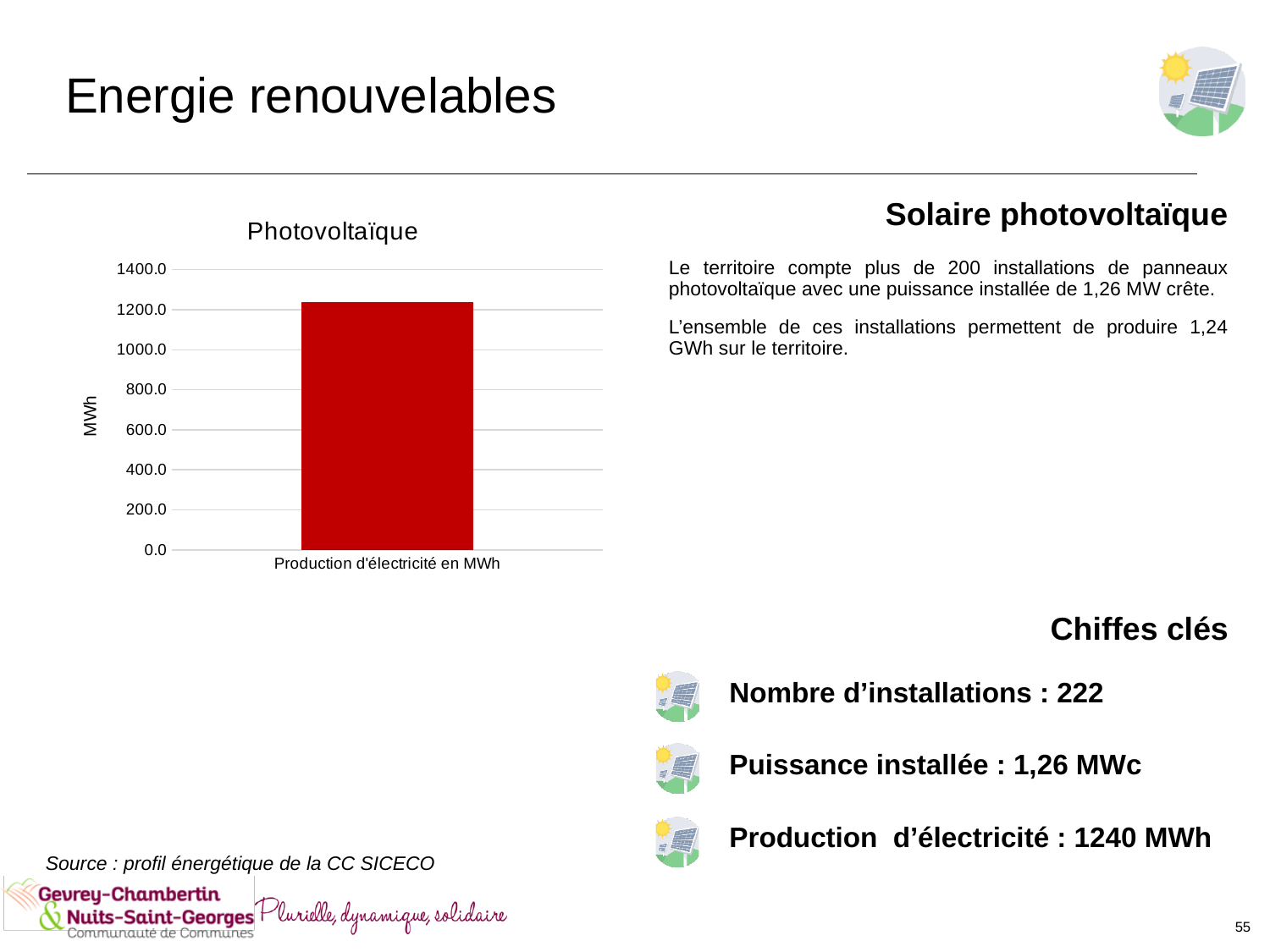
What unit is shown on the y axis of the chart? MWh What is the highest tick value shown on the y axis of the chart? 1400.0 Is the value for Production d'électricité en MWh greater or less than 1400? less What is the label of the category on the x axis of the chart? Production d'électricité en MWh Is the value for Production d'électricité en MWh greater or less than 1000? greater How many bars does the chart show? 1 What kind of chart is shown on the slide? bar chart Is the value for Production d'électricité en MWh greater or less than 800? greater